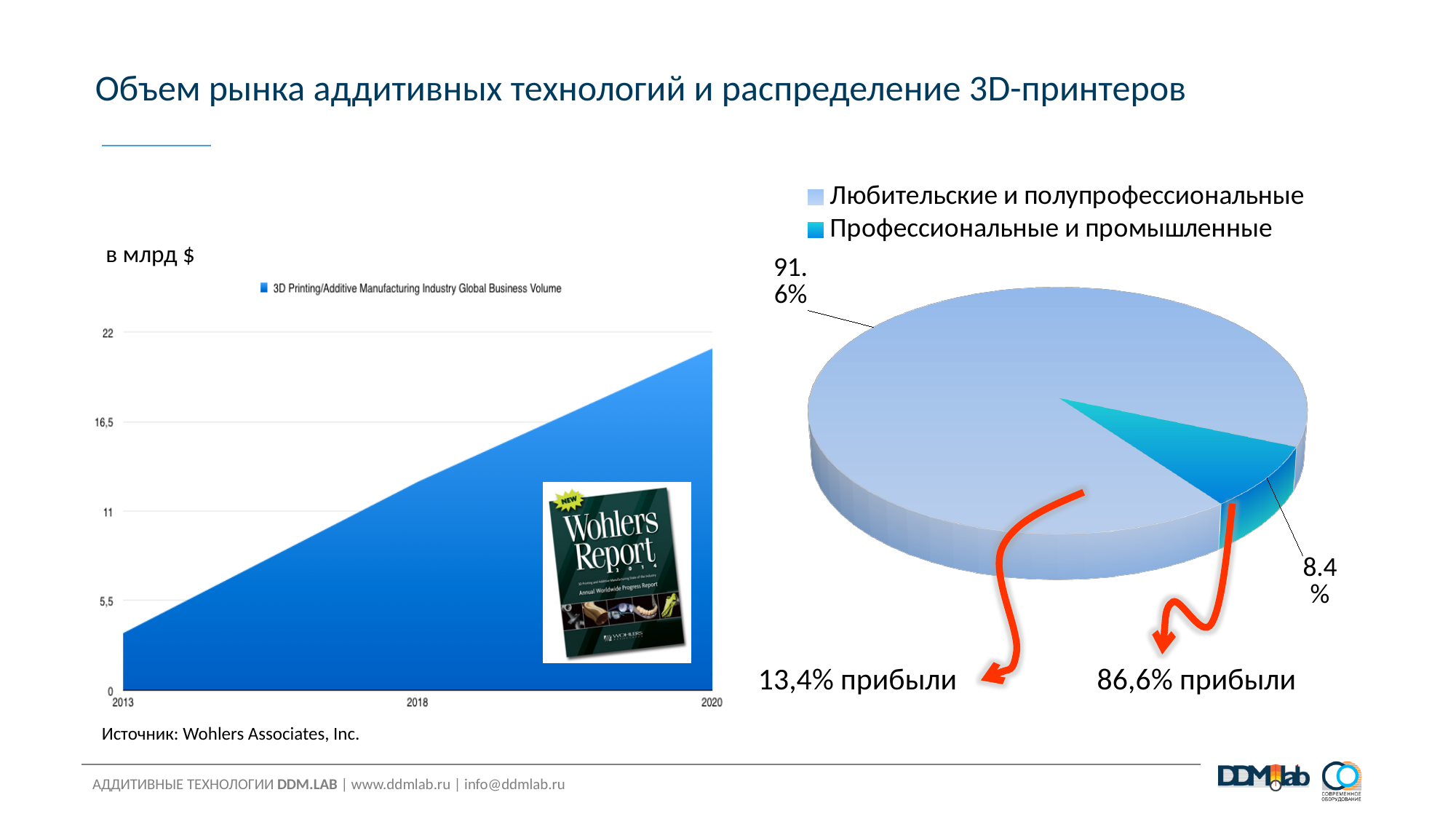
What kind of chart is shown on the right side of the slide? Pie chart In the chart on the left, does the business volume rise or fall from 2013 to 2020? Rises In the chart on the left, is the value for 2020 greater or less than 16.5? greater In the pie chart on the right, what share do Профессиональные и промышленные printers have? 8.4% What kind of chart is shown on the left side of the slide? Area chart In the pie chart on the right, how many categories does the legend list? 2 In the pie chart on the right, which category has the larger slice? Любительские и полупрофессиональные In the pie chart on the right, by how many percentage points does the Любительские и полупрофессиональные slice exceed the Профессиональные и промышленные slice? 83.2 percentage points What is the legend entry of the chart on the left? 3D Printing/Additive Manufacturing Industry Global Business Volume In the chart on the left, how many years are labeled on the x axis? 3 In the pie chart on the right, what share do Любительские и полупрофессиональные printers have? 91.6% In the chart on the left, is the value for 2013 greater or less than 5.5? less